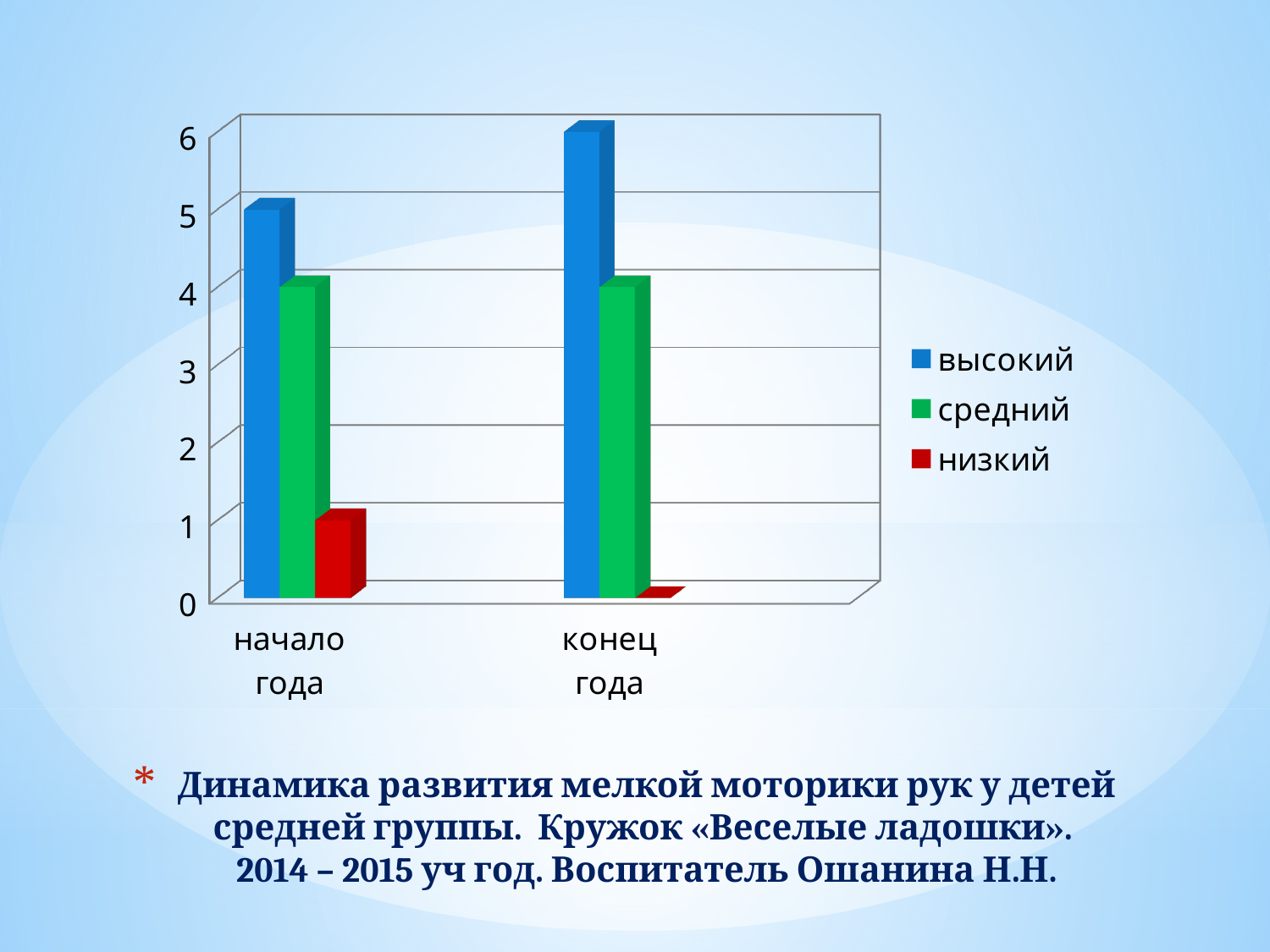
What is the value for высокий at начало года? 5 Which colour represents the series низкий in the legend? red Which series has the lowest value at начало года? низкий Does the value for высокий rise or fall from начало года to конец года? rise What type of chart is shown on the slide? bar chart What is the value for средний at конец года? 4 What is the difference between the высокий values at конец года and начало года? 1 How many categories are shown on the x axis? 2 How many series does the legend list? 3 What is the value for высокий at конец года? 6 Which series has the highest value at конец года? высокий What is the value for низкий at начало года? 1